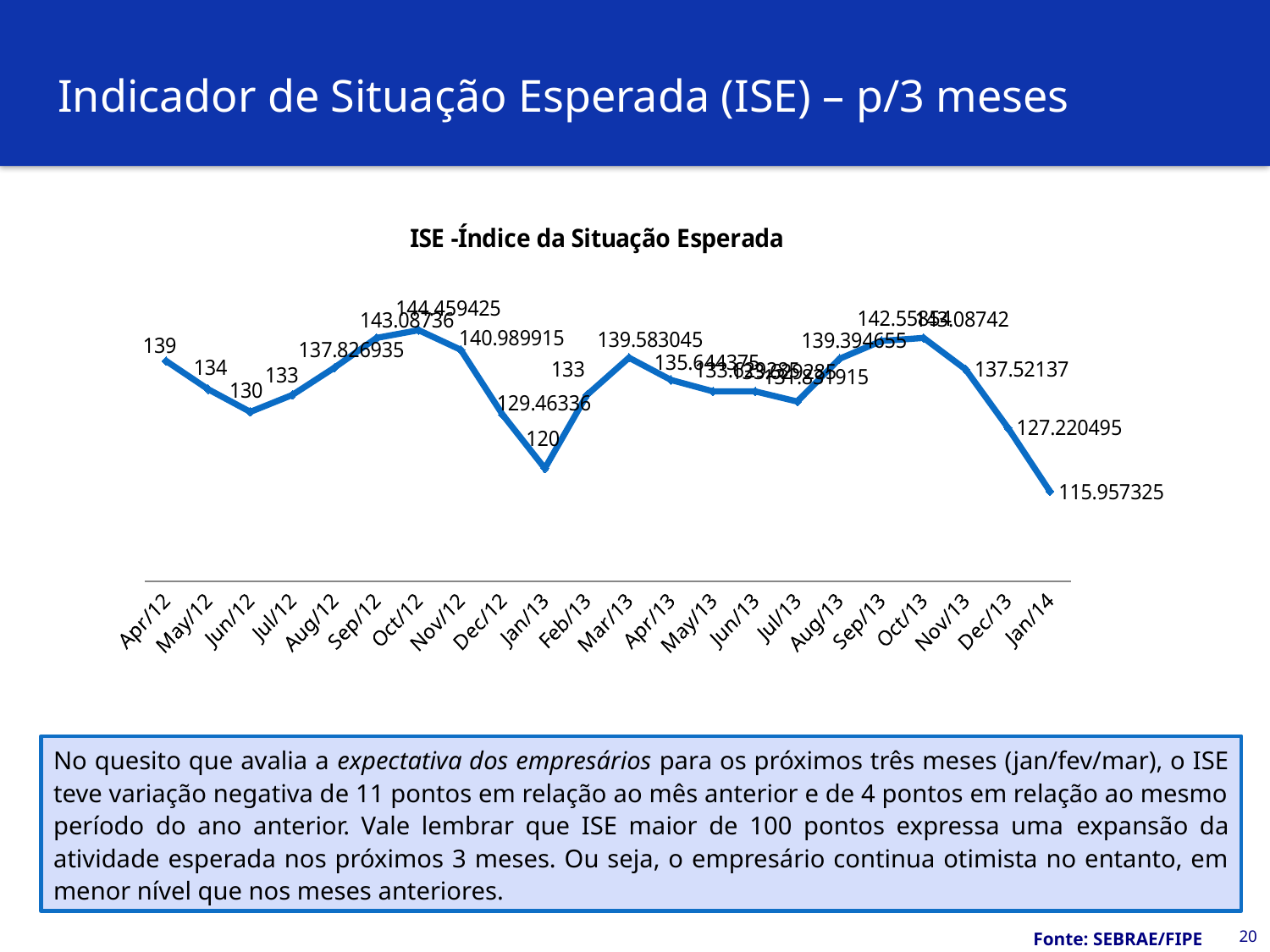
What is the ISE value for Dec/13? 127.220495 What is the title of the chart? ISE -Índice da Situação Esperada Does the ISE rise or fall from Oct/13 to Jan/14? Fall What type of chart is shown on the slide? Line chart What is the ISE value for Jan/13? 120 Which month has the lowest ISE value? Jan/14 What is the ISE value for Oct/12? 144.459425 What is the ISE value for Jan/14? 115.957325 Which is larger, the ISE value for Mar/13 or for Feb/13? Mar/13 What is the difference between the ISE values for Apr/12 and Jun/12? 9 What is the ISE value for Apr/12? 139 How many months are plotted on the x axis? 22